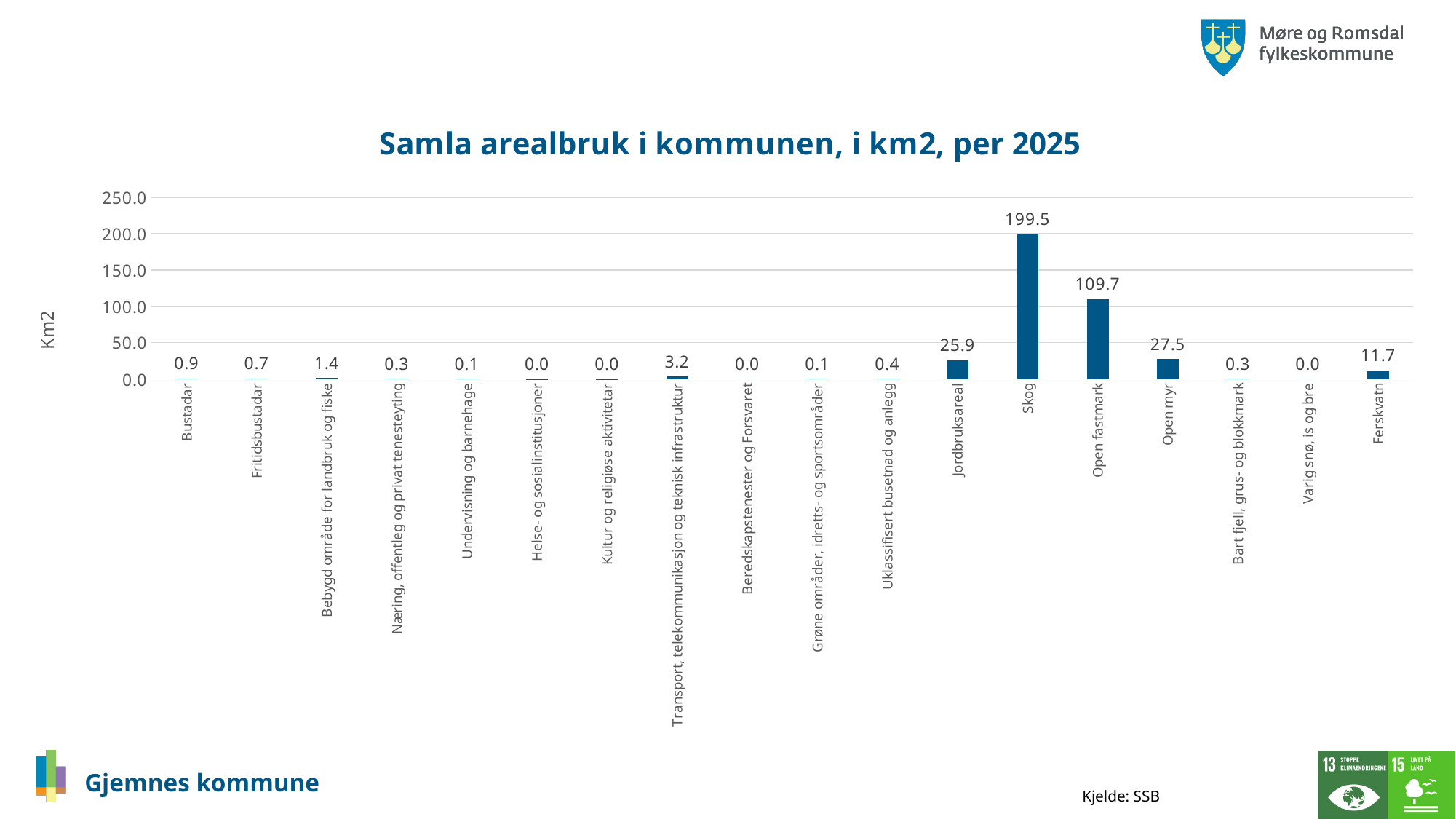
What is the difference between the values for Open myr and Jordbruksareal? 1.6 What kind of chart is shown on the slide? bar chart What is the value for Skog? 199.5 Is the value for Skog greater or less than 150.0? greater What is the difference between the values for Skog and Open fastmark? 89.8 What is the value for Jordbruksareal? 25.9 What is the title of the chart? Samla arealbruk i kommunen, i km2, per 2025 How many categories are shown on the x axis? 18 What is the value for Ferskvatn? 11.7 Which category has the highest value? Skog What is the value for Open fastmark? 109.7 Which is larger, the value for Open myr or the value for Ferskvatn? Open myr